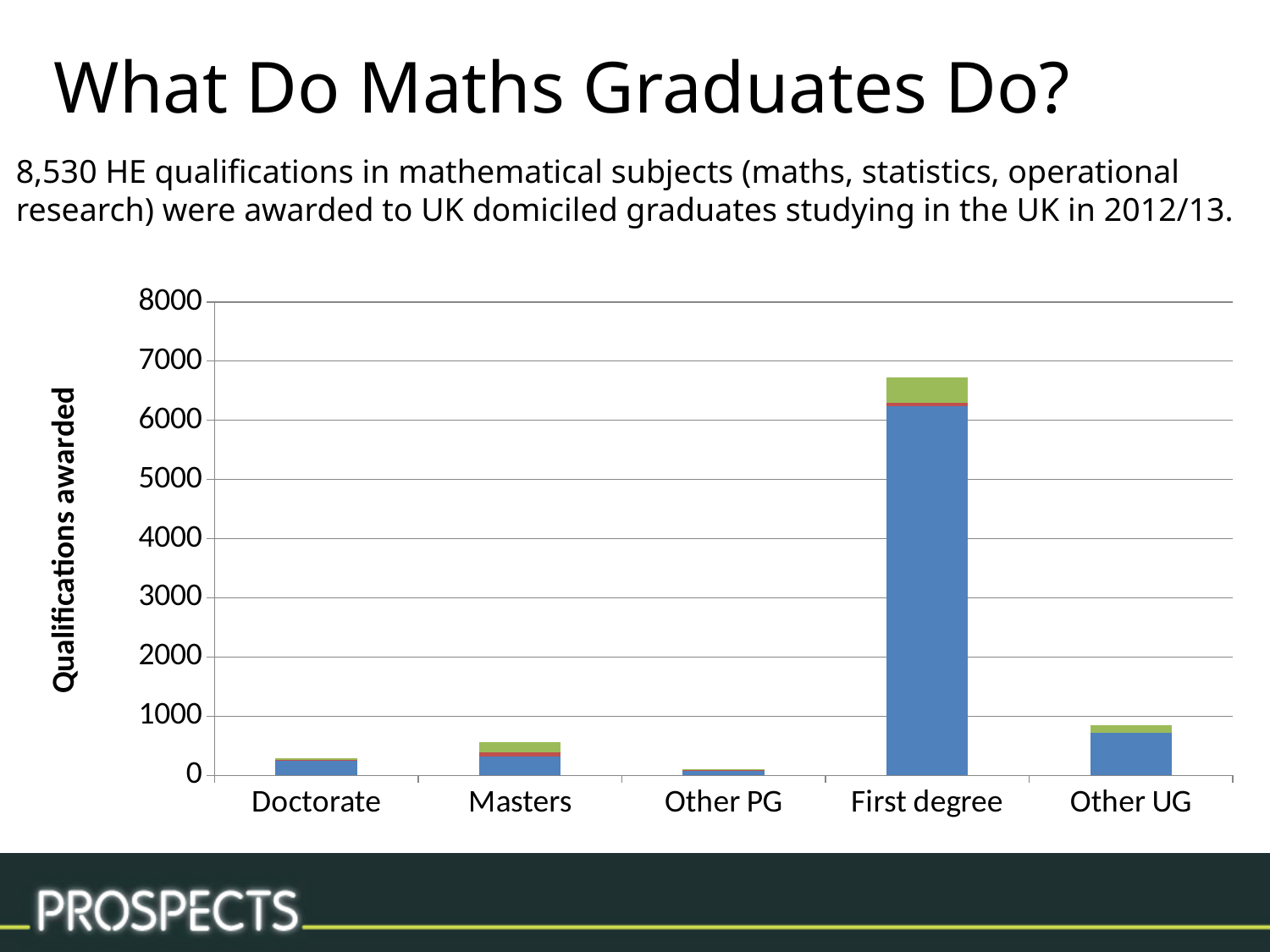
What is the label on the vertical axis of the chart? Qualifications awarded Is the total value for First degree greater or less than 7000? less Is the total value for Other UG greater or less than 1000? less What kind of chart is shown on the slide? bar chart Is the total value for First degree greater or less than 6000? greater Which category has the highest number of qualifications awarded? First degree Which has more qualifications awarded, Masters or Doctorate? Masters Which has more qualifications awarded, Other UG or Masters? Other UG Which category has the lowest number of qualifications awarded? Other PG What is the highest value shown on the vertical axis of the chart? 8000 How many qualification categories are shown on the x axis of the chart? 5